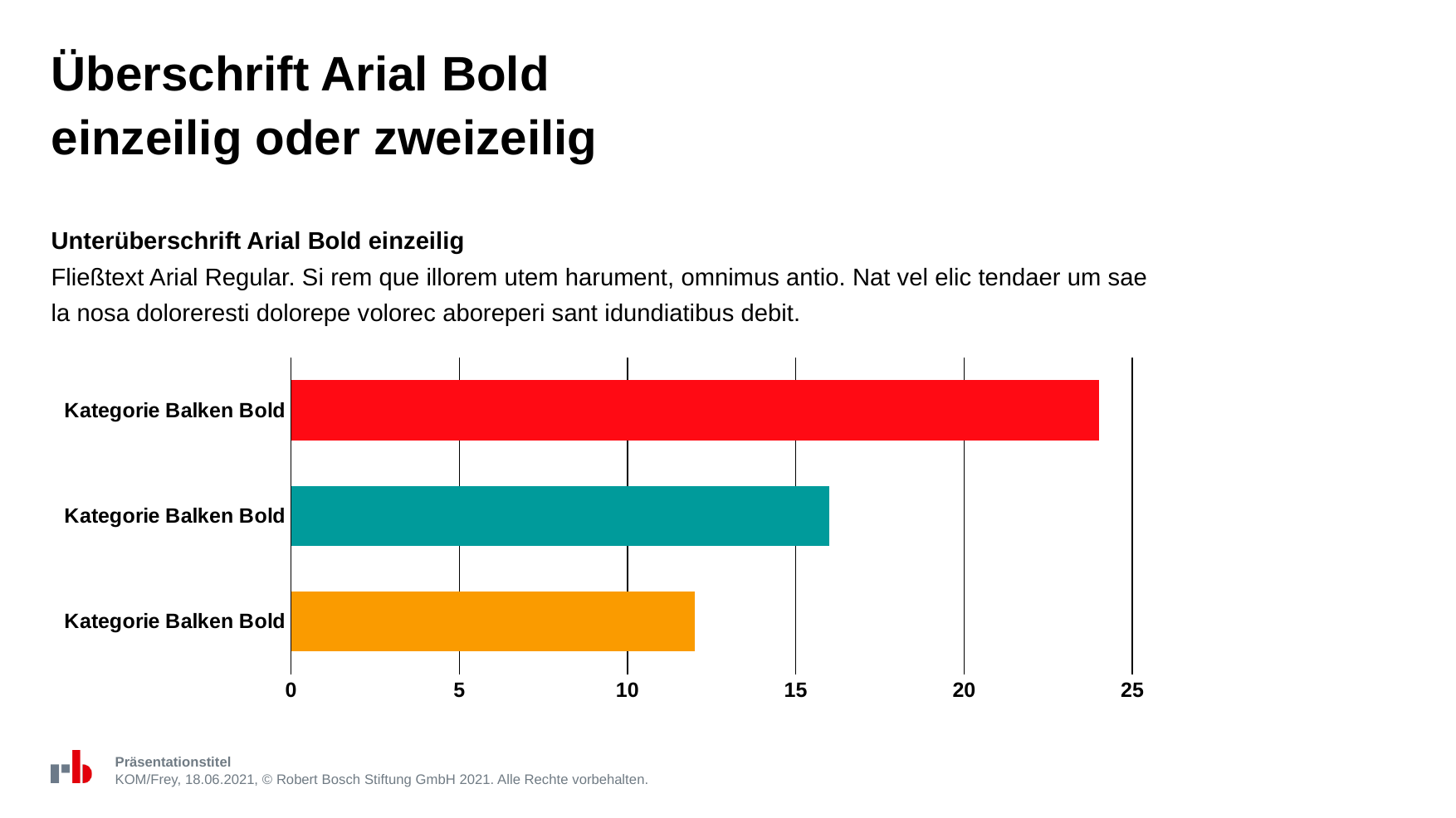
Is the value of the bottom (orange) bar greater or less than 10? greater Is the value of the middle (teal) bar greater or less than 20? less How many bars does the chart have? 3 What kind of chart is shown on the slide? bar chart What is the highest value shown on the horizontal axis? 25 What colour is the top bar in the chart? red Which is larger, the value of the middle (teal) bar or the bottom (orange) bar? the middle (teal) bar Is the value of the middle (teal) bar greater or less than 15? greater Which bar is the shortest: the top (red), middle (teal) or bottom (orange) bar? the bottom (orange) bar Which bar is the longest: the top (red), middle (teal) or bottom (orange) bar? the top (red) bar